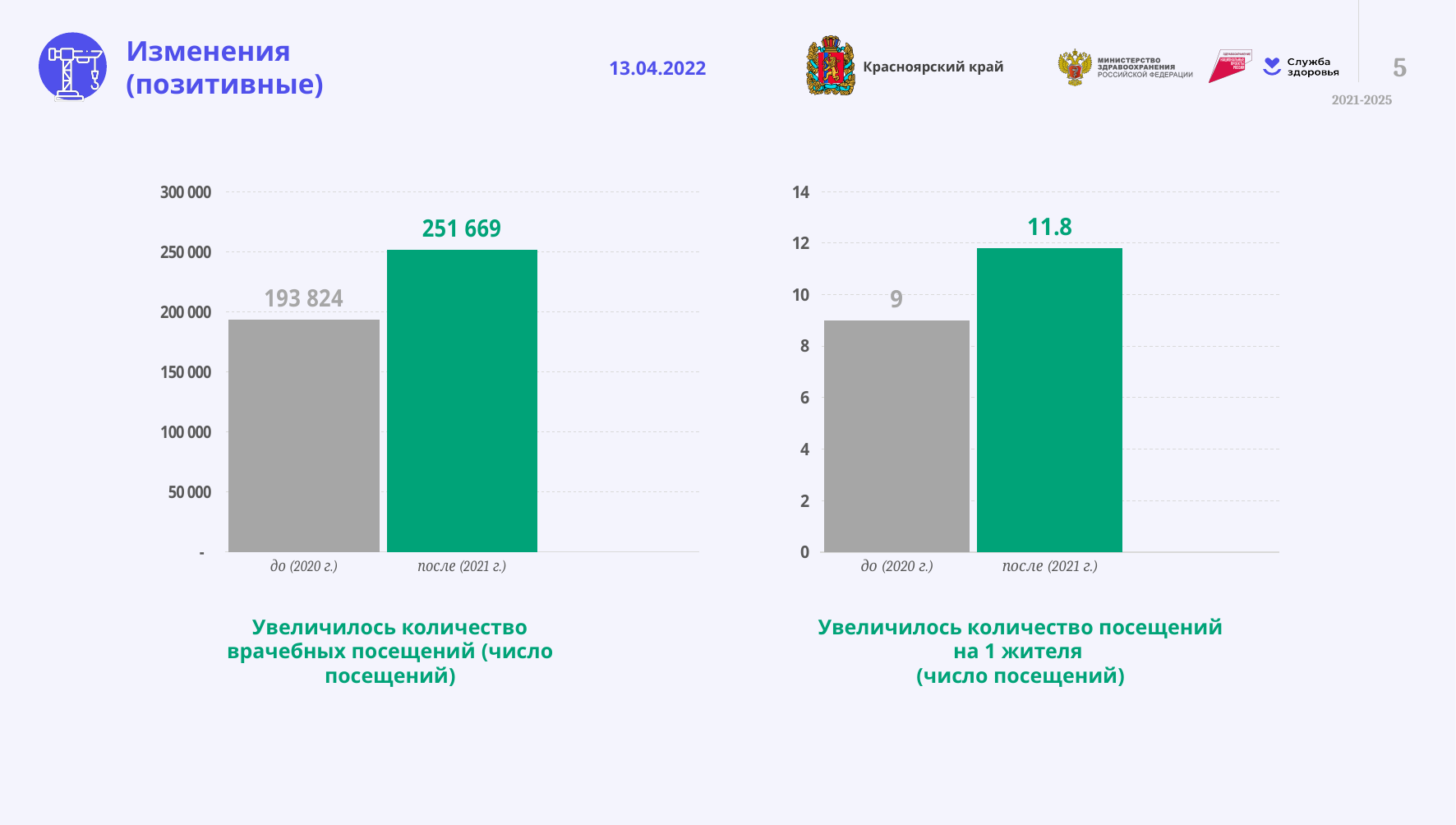
In the right chart (посещения на 1 жителя), which category has the lowest value? до (2020 г.) In the right chart (посещения на 1 жителя), do the values rise or fall from 'до (2020 г.)' to 'после (2021 г.)'? rise In the left chart (врачебные посещения), what is the difference between the 'после (2021 г.)' and 'до (2020 г.)' values? 57 845 In the right chart (посещения на 1 жителя), what is the difference between the 'после (2021 г.)' and 'до (2020 г.)' values? 2.8 In the right chart (посещения на 1 жителя), how many categories are shown on the x axis? 2 What type of chart is the left chart (врачебные посещения)? bar chart In the left chart (врачебные посещения), which category has the highest value? после (2021 г.) In the left chart (врачебные посещения), what is the value for 'после (2021 г.)'? 251 669 In the left chart (врачебные посещения), what is the value for 'до (2020 г.)'? 193 824 In the left chart (врачебные посещения), is the value for 'до (2020 г.)' greater or less than 200 000? less In the right chart (посещения на 1 жителя), what is the value for 'после (2021 г.)'? 11.8 In the right chart (посещения на 1 жителя), what is the value for 'до (2020 г.)'? 9